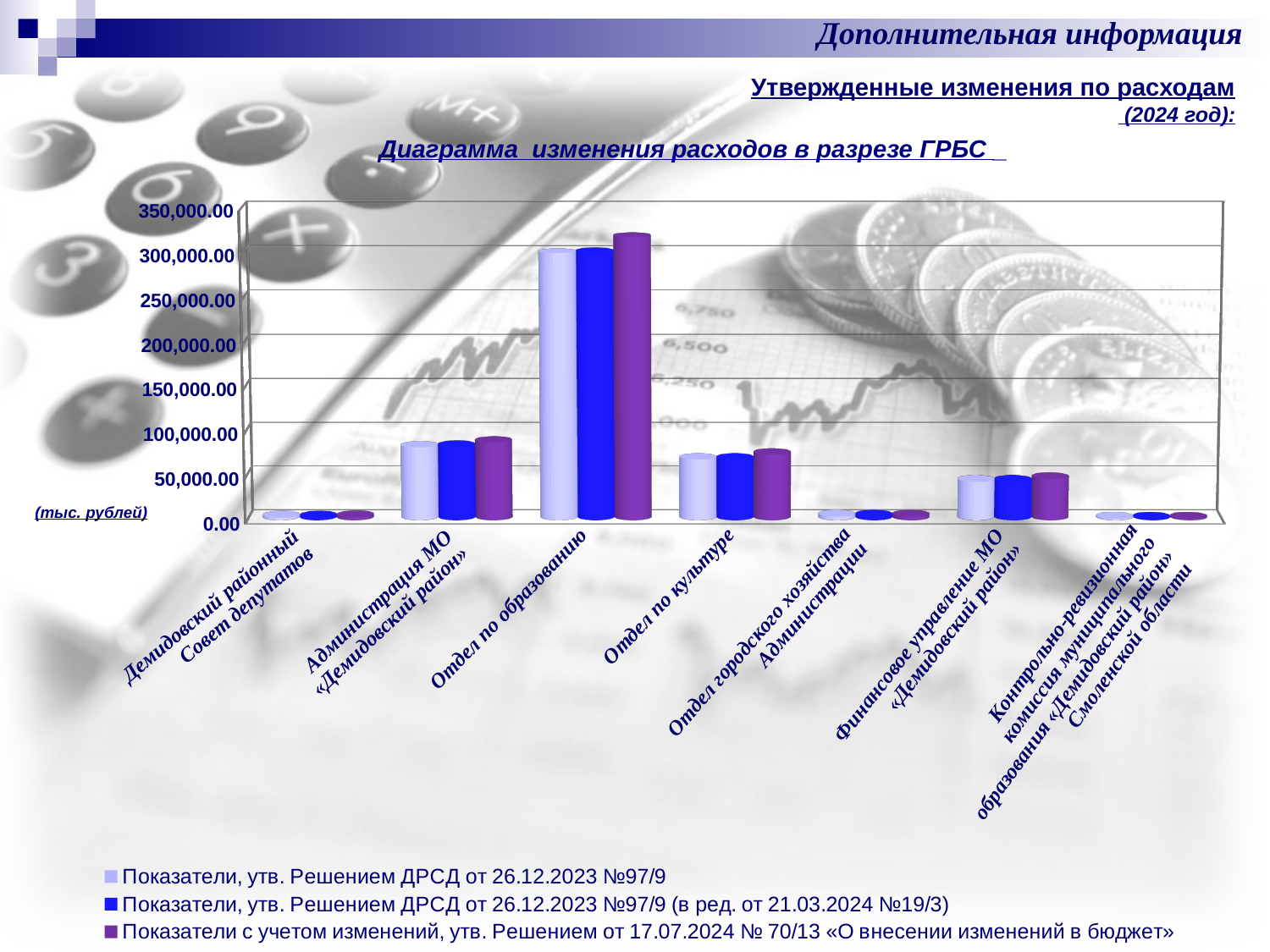
What kind of chart is shown on the slide? Bar chart Is the value for Финансовое управление МО «Демидовский район» (Показатели, утв. Решением ДРСД от 26.12.2023 №97/9) greater or less than 100,000.00? less Which category has the highest values in the chart? Отдел по образованию How many series does the chart legend list? 3 Is the value for Администрация МО «Демидовский район» (Показатели, утв. Решением ДРСД от 26.12.2023 №97/9) greater or less than 100,000.00? less Which category has larger values: Администрация МО «Демидовский район» or Отдел по культуре? Администрация МО «Демидовский район» Is the value for Отдел по культуре (Показатели, утв. Решением ДРСД от 26.12.2023 №97/9) greater or less than 50,000.00? greater What is the title of the chart? Диаграмма изменения расходов в разрезе ГРБС In what units are the values on the chart's vertical axis expressed, according to the label next to the axis? тыс. рублей How many categories (ГРБС) are shown along the x axis of the chart? 7